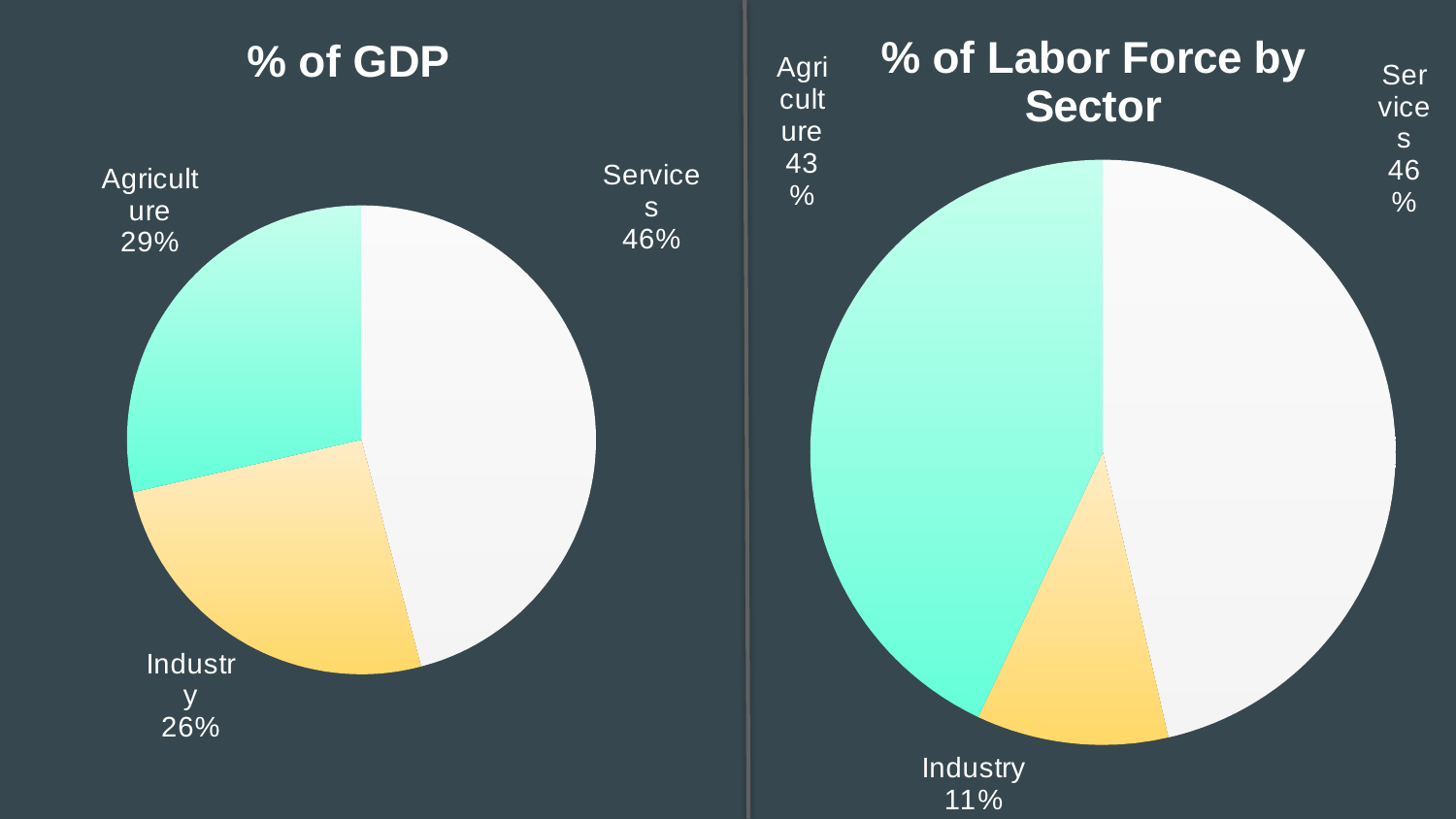
In the '% of GDP' chart, which is larger, Agriculture or Industry? Agriculture How many slices does the '% of Labor Force by Sector' chart have? 3 In the '% of Labor Force by Sector' chart, what is the value for Industry? 11% In the '% of GDP' chart, what is the value for Services? 46% In the '% of Labor Force by Sector' chart, what is the difference between the Services and Agriculture values? 3% In the '% of Labor Force by Sector' chart, what is the value for Agriculture? 43% In the '% of Labor Force by Sector' chart, which sector has the smallest share? Industry In the '% of GDP' chart, which sector has the largest share? Services In the '% of GDP' chart, what is the value for Agriculture? 29% What is the title of the chart on the right side of the slide? % of Labor Force by Sector What kind of chart is the '% of GDP' chart? Pie chart In the '% of GDP' chart, what is the difference between the Services and Industry values? 20%